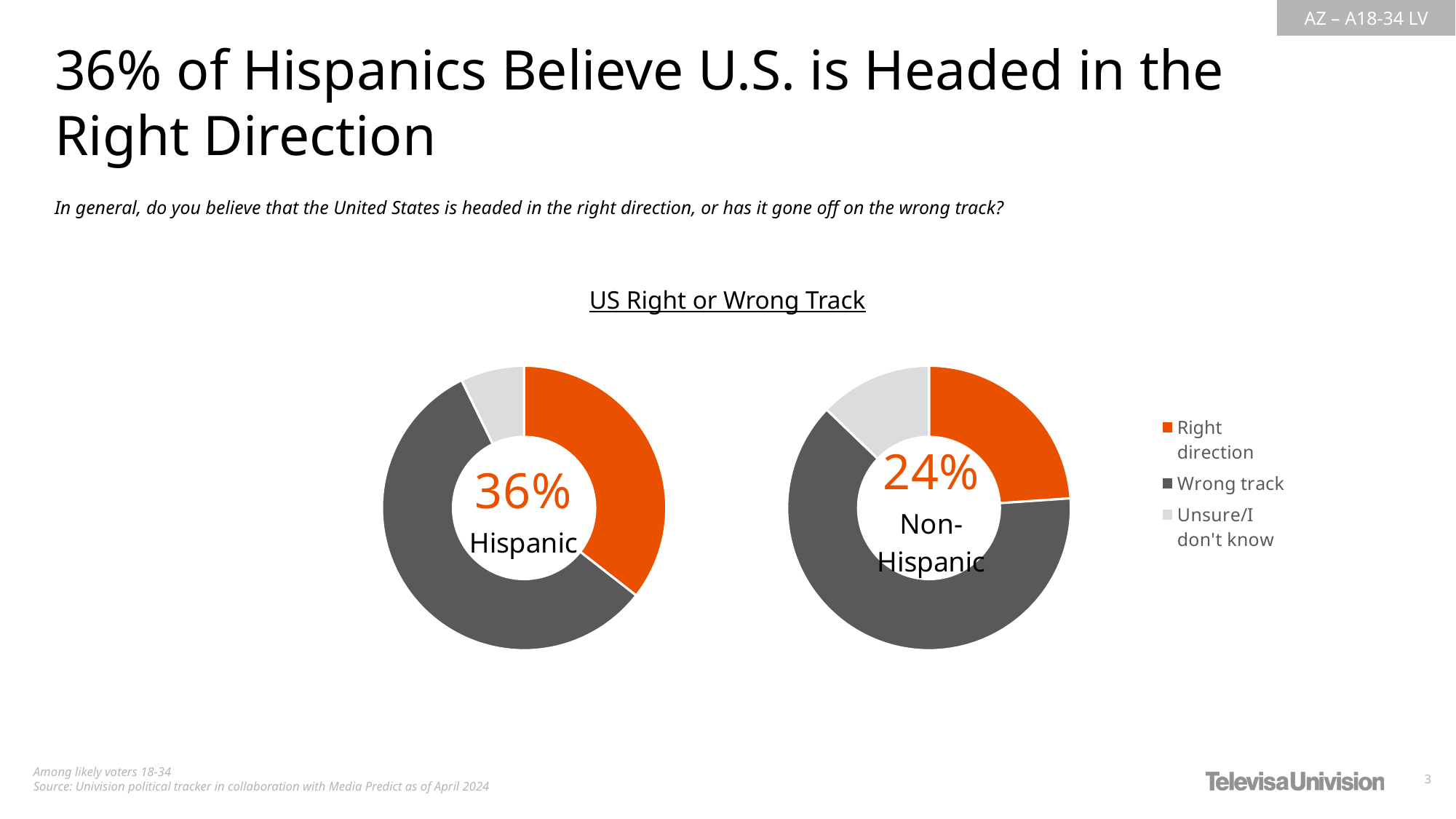
What is the difference between the Hispanic and Non-Hispanic 'Right direction' shares? 12 percentage points In the Non-Hispanic donut chart, which response category is the smallest slice? Unsure/I don't know How many donut charts are shown on the slide? 2 Which group has the larger share saying the U.S. is headed in the right direction, Hispanic or Non-Hispanic? Hispanic In the Hispanic donut chart, which response category is the smallest slice? Unsure/I don't know In the Hispanic donut chart, which response category is the largest slice? Wrong track What is the title shown above the two donut charts? US Right or Wrong Track In the Non-Hispanic donut chart, what share of respondents said the U.S. is headed in the right direction? 24% Which colour represents 'Wrong track' in the donut charts? Dark grey How many categories does the legend list for the US Right or Wrong Track charts? 3 In the Hispanic donut chart, what share of respondents said the U.S. is headed in the right direction? 36% What kind of chart is used to show the US Right or Wrong Track results? Donut (pie) chart